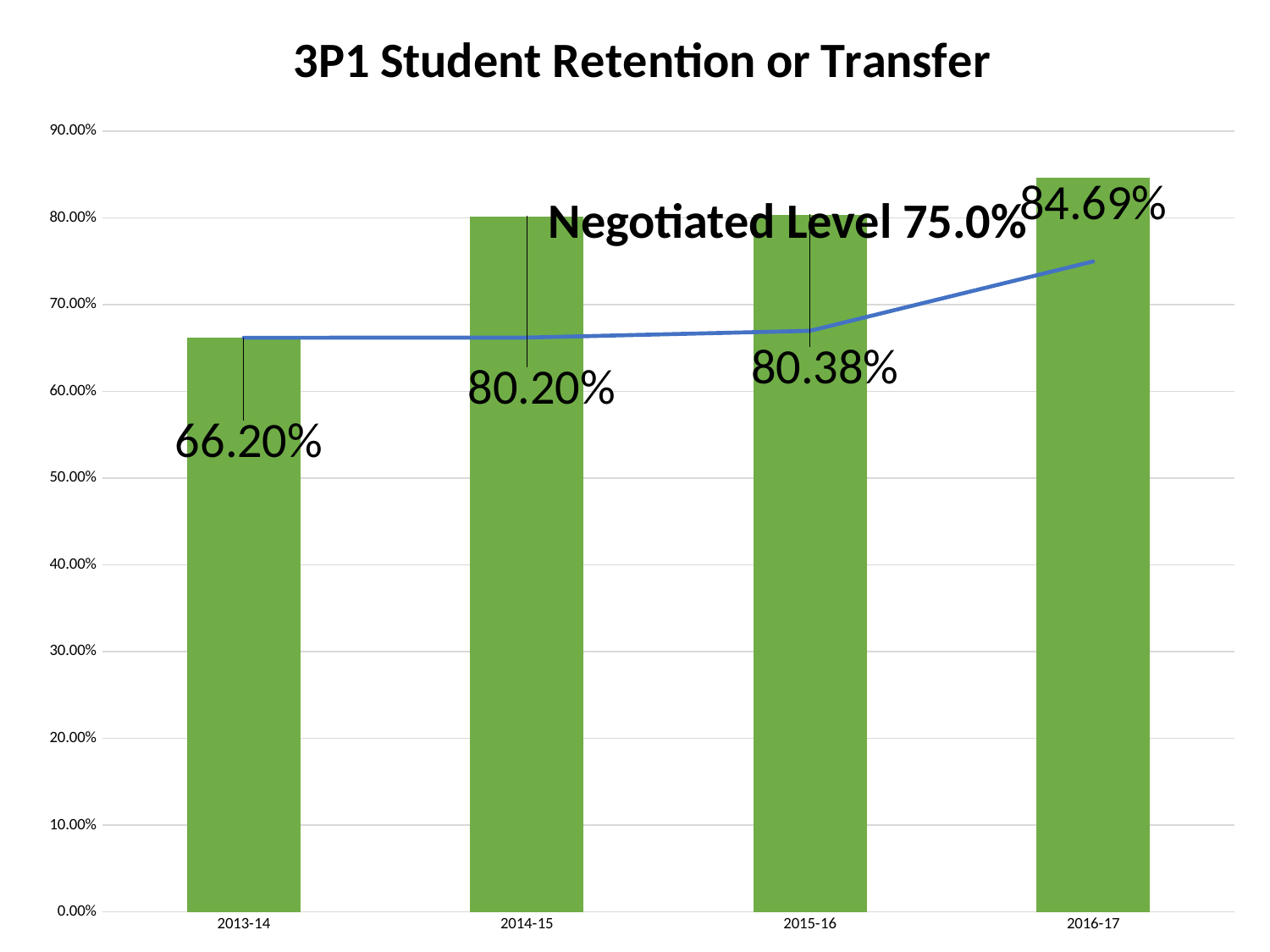
Which year has the lowest value? 2013-14 Which is larger, the value for 2014-15 or the value for 2013-14? 2014-15 What is the value for 2016-17? 84.69% Is the negotiated level line for 2013-14 greater or less than 70.00%? less What is the difference between the values for 2016-17 and 2013-14? 18.49% What is the value for 2015-16? 80.38% What is the title of the chart? 3P1 Student Retention or Transfer What is the value for 2014-15? 80.20% What is the value for 2013-14? 66.20% What kind of chart is this? combination bar and line chart How many years are shown on the x axis? 4 Which year has the highest value? 2016-17